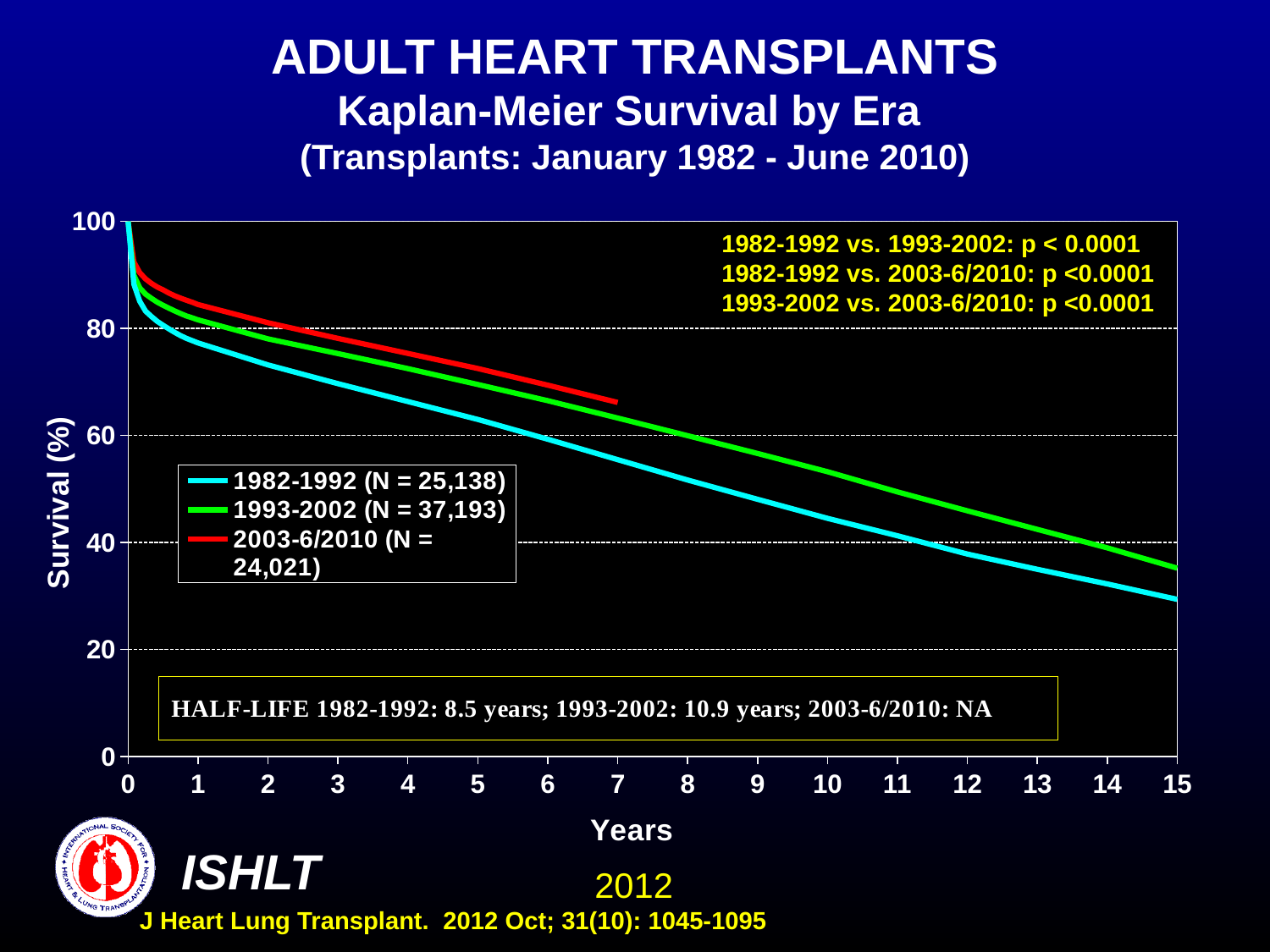
Which era has the highest survival at 5 years? 2003-6/2010 Is the survival for the 1982-1992 era at 15 years greater or less than 40? less What kind of chart is shown on the slide? Line chart Is the survival for the 2003-6/2010 era at 7 years greater or less than 60? greater What is the N for the 1993-2002 era shown in the legend? 37,193 What is the half-life for the 1982-1992 era? 8.5 years What is the half-life given for the 2003-6/2010 era? NA How many series does the legend list? 3 What is the half-life for the 1993-2002 era? 10.9 years Do the survival curves rise or fall as years increase? Fall Which era has the lowest survival at 10 years? 1982-1992 What is the N for the 2003-6/2010 era shown in the legend? 24,021